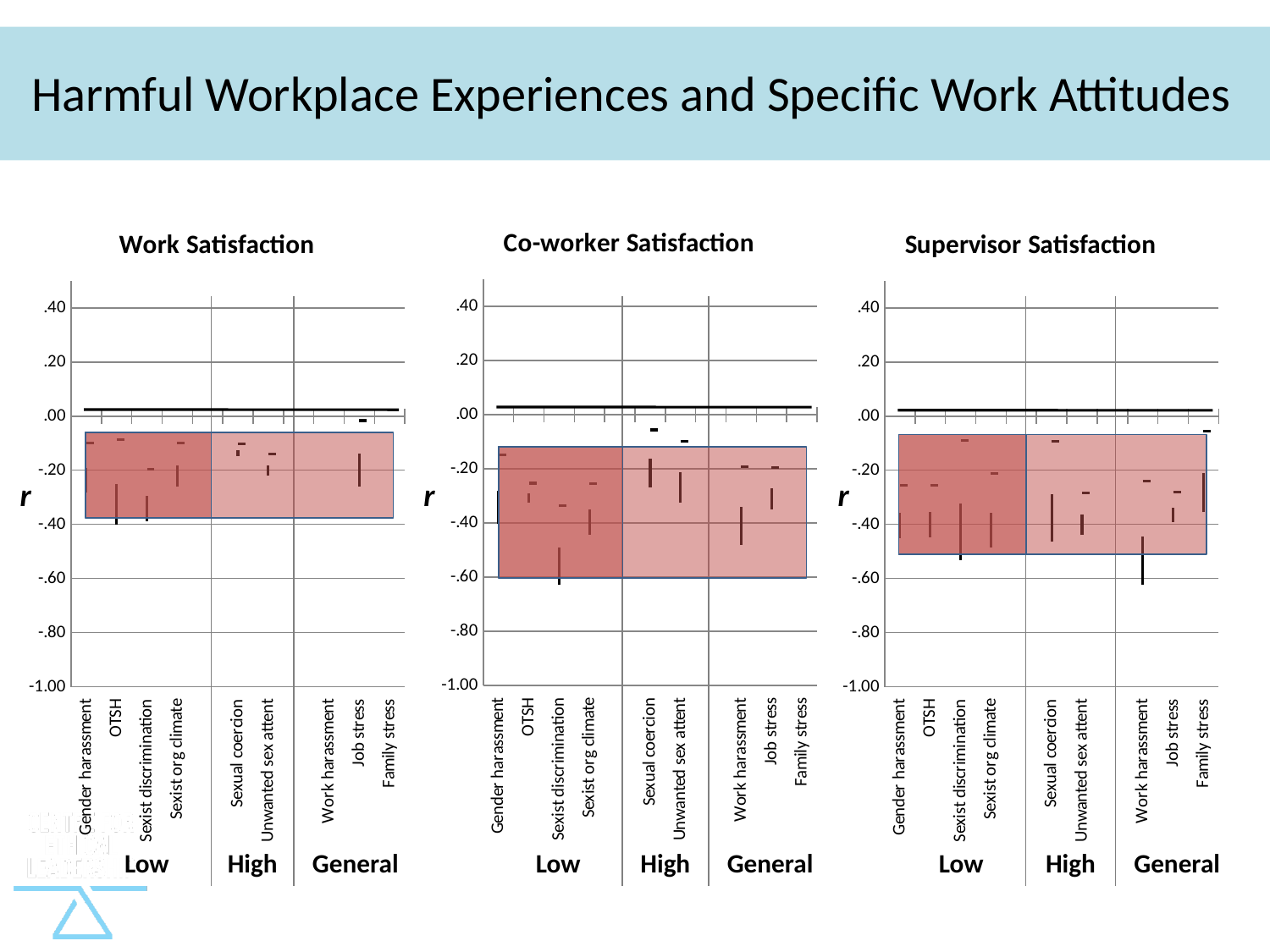
In the Co-worker Satisfaction chart, how many groups are the categories divided into along the x axis? 3 In the Supervisor Satisfaction chart, is the value for Gender harassment greater or less than .00? less In the Supervisor Satisfaction chart, is the value for Work harassment greater or less than -.40? less What is the highest tick value shown on the y axis of the Work Satisfaction chart? .40 In the Co-worker Satisfaction chart, is the value for Sexist discrimination greater or less than -.40? less How many charts are shown on the slide? 3 In the Work Satisfaction chart, how many categories are listed along the x axis? 9 What label is shown on the y axis of each chart? r What are the three group labels shown beneath the x axis of the Supervisor Satisfaction chart? Low, High, General